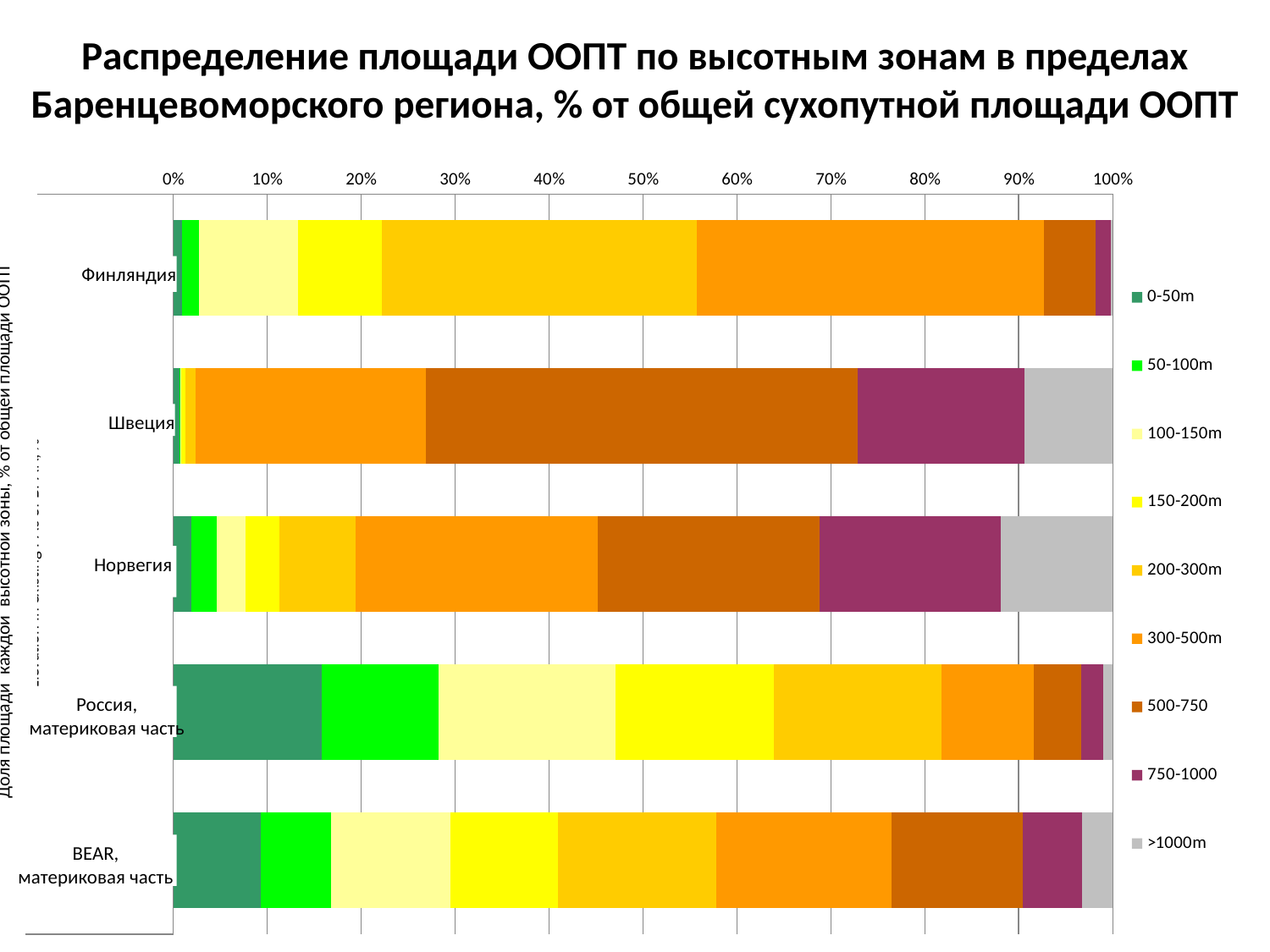
Which has the larger share of the 500-750 zone, Швеция or Финляндия? Швеция What is the maximum value shown on the horizontal axis? 100% Is the share of the 500-750 zone for Швеция greater or less than 40%? greater Is the share of the 0-50m zone for Россия, материковая часть greater or less than 10%? greater Which legend entry represents the highest altitude zone? >1000m How many altitude zones does the legend list? 9 Which country or region has the largest share in the 0-50m zone? Россия, материковая часть How many countries or regions are plotted on the chart? 5 Is the share of the 300-500m zone for Финляндия greater or less than 30%? greater What kind of chart is shown on the slide? stacked bar chart Which has the larger share of the 0-50m zone, Россия, материковая часть or Норвегия? Россия, материковая часть